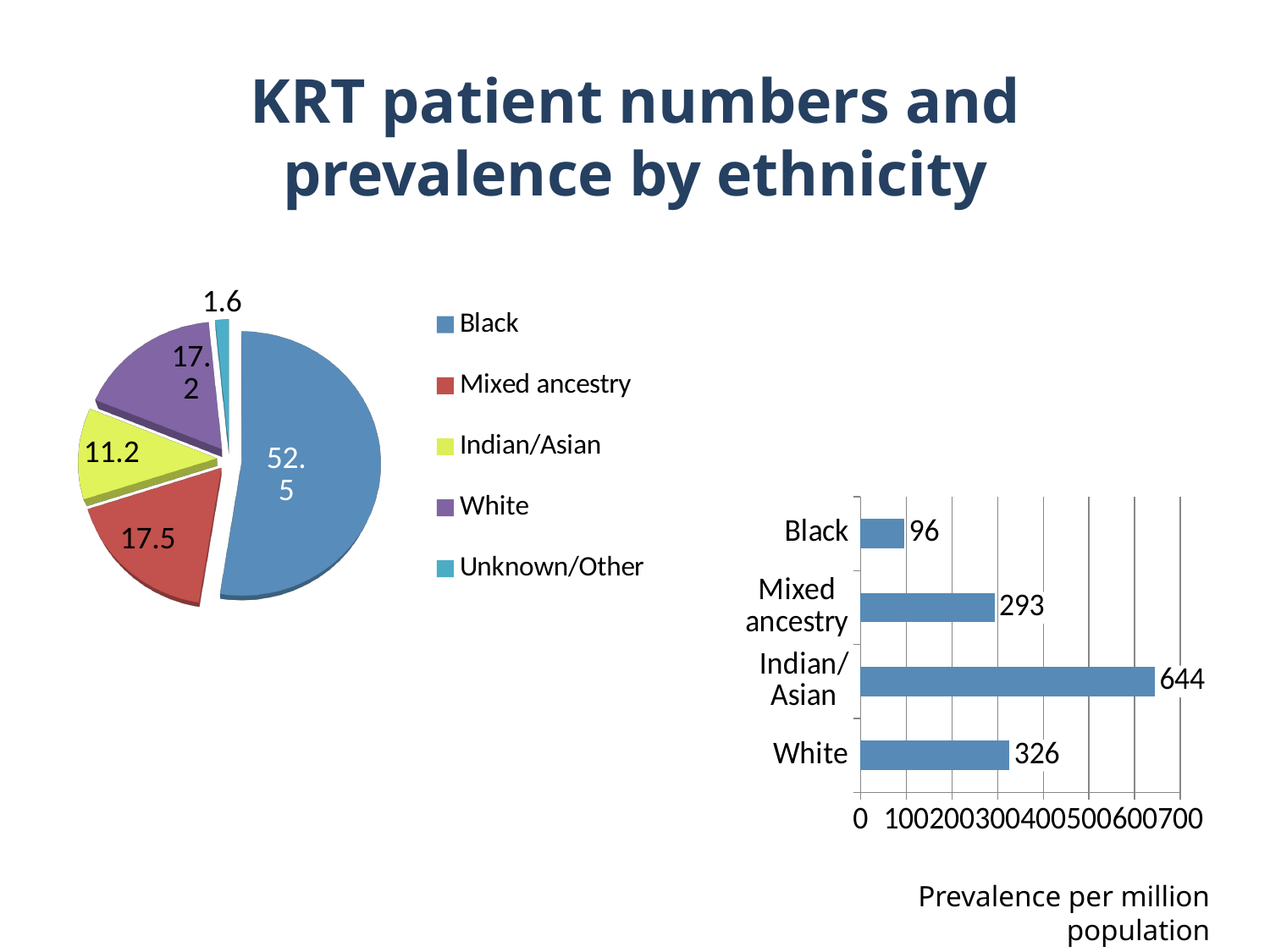
On the bar chart on the right, which category has the highest prevalence per million population? Indian/Asian On the pie chart on the left, which category has the smallest slice? Unknown/Other On the pie chart on the left, which category has the largest slice? Black On the pie chart on the left, how many categories does the legend list? 5 On the pie chart on the left, what is the value shown for the Black slice? 52.5 On the bar chart on the right, what is the difference between the White value and the Mixed ancestry value? 33 On the pie chart on the left, what is the value shown for the Indian/Asian slice? 11.2 On the bar chart on the right, which is larger, the value for White or the value for Mixed ancestry? White What kind of chart is the chart on the right of the slide? Bar chart On the bar chart on the right, what is the prevalence per million population for Indian/Asian? 644 On the bar chart on the right, what is the prevalence per million population for Black? 96 On the pie chart on the left, what is the difference between the Mixed ancestry value and the White value? 0.3